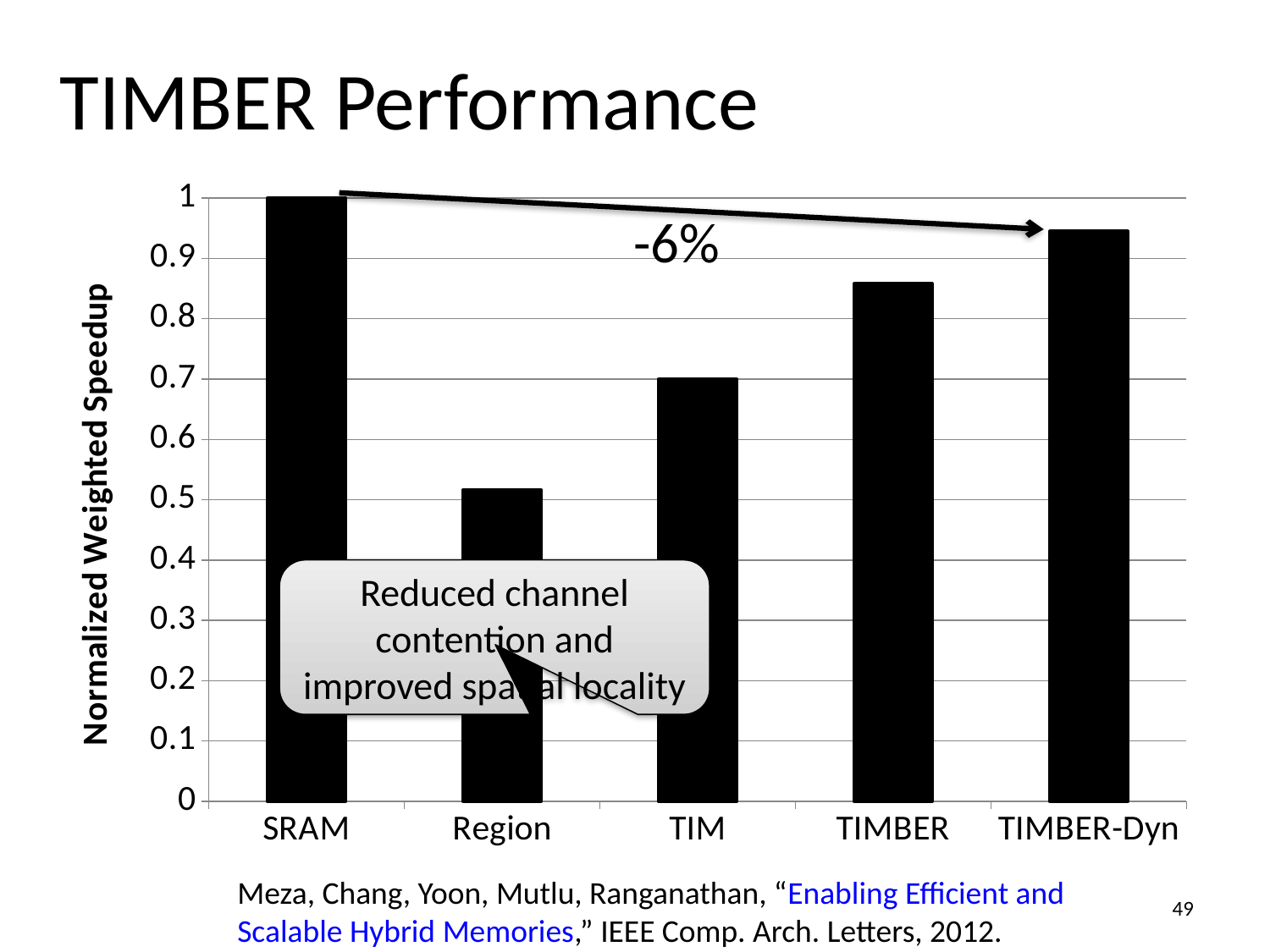
Is the value for Region greater or less than 0.6? less Is the value for TIM greater or less than 0.8? less Is the value for TIMBER-Dyn greater or less than 0.9? greater What is the title of the y axis of the chart? Normalized Weighted Speedup What is the normalized weighted speedup for SRAM? 1 Which category has the lowest normalized weighted speedup? Region How many categories are shown on the x axis of the chart? 5 What kind of chart is shown on the slide? bar chart Which has a higher normalized weighted speedup, TIMBER or TIMBER-Dyn? TIMBER-Dyn Which category has the highest normalized weighted speedup? SRAM Which has a higher normalized weighted speedup, TIM or TIMBER? TIMBER